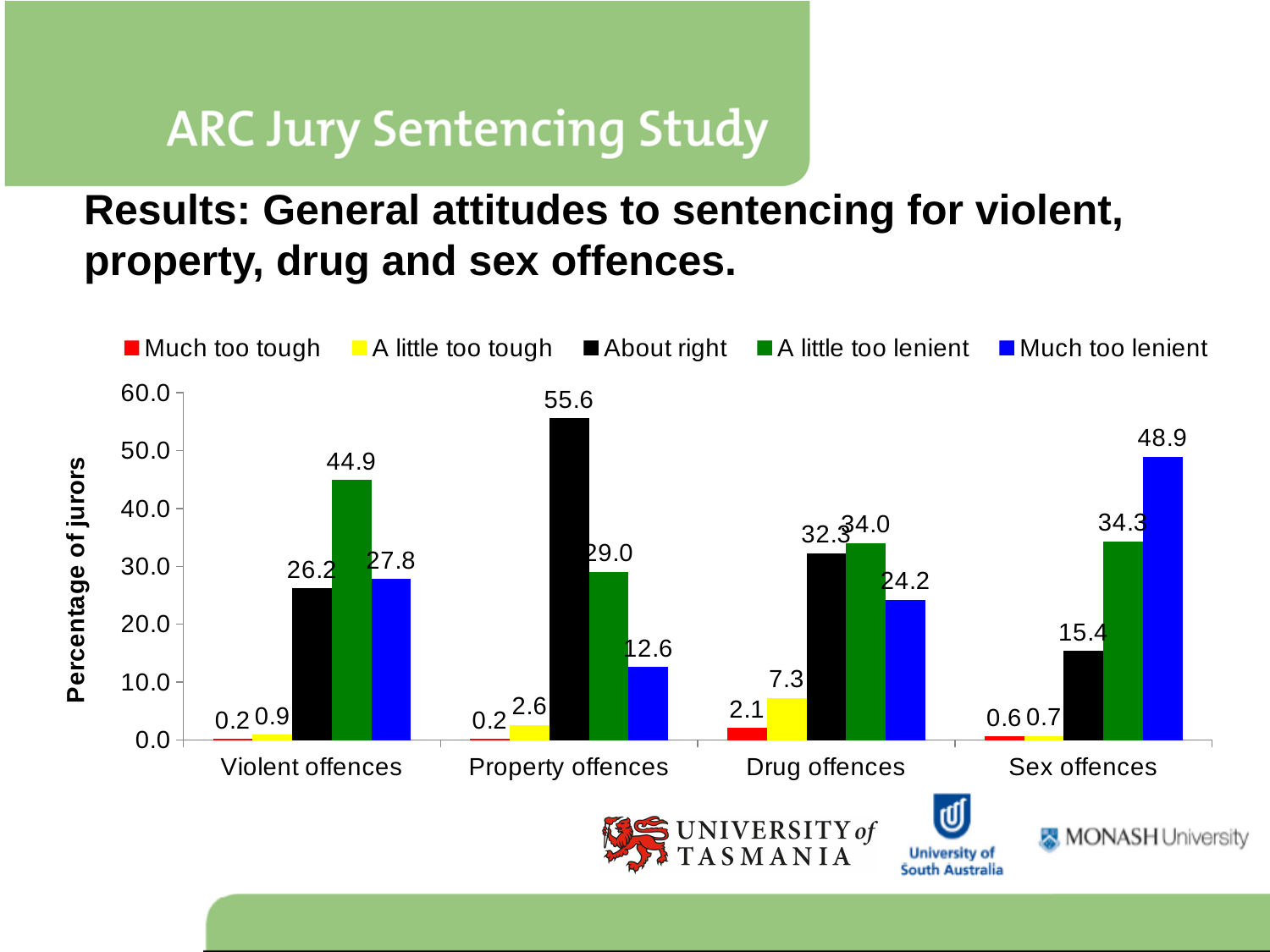
What is the value for 'A little too tough' for drug offences? 7.3 What is the label of the y axis? Percentage of jurors How many series does the legend list? 5 What is the value for 'Much too lenient' for sex offences? 48.9 What kind of chart is shown on the slide? Bar chart What is the value for 'A little too lenient' for violent offences? 44.9 Which offence category has the lowest 'Much too lenient' value? Property offences How many offence categories are shown on the x axis? 4 What is the difference between the 'Much too lenient' values for sex offences and violent offences? 21.1 What percentage of jurors said sentencing for property offences was 'About right'? 55.6 For drug offences, which is larger: 'About right' or 'Much too lenient'? About right Which offence category has the highest 'About right' value? Property offences